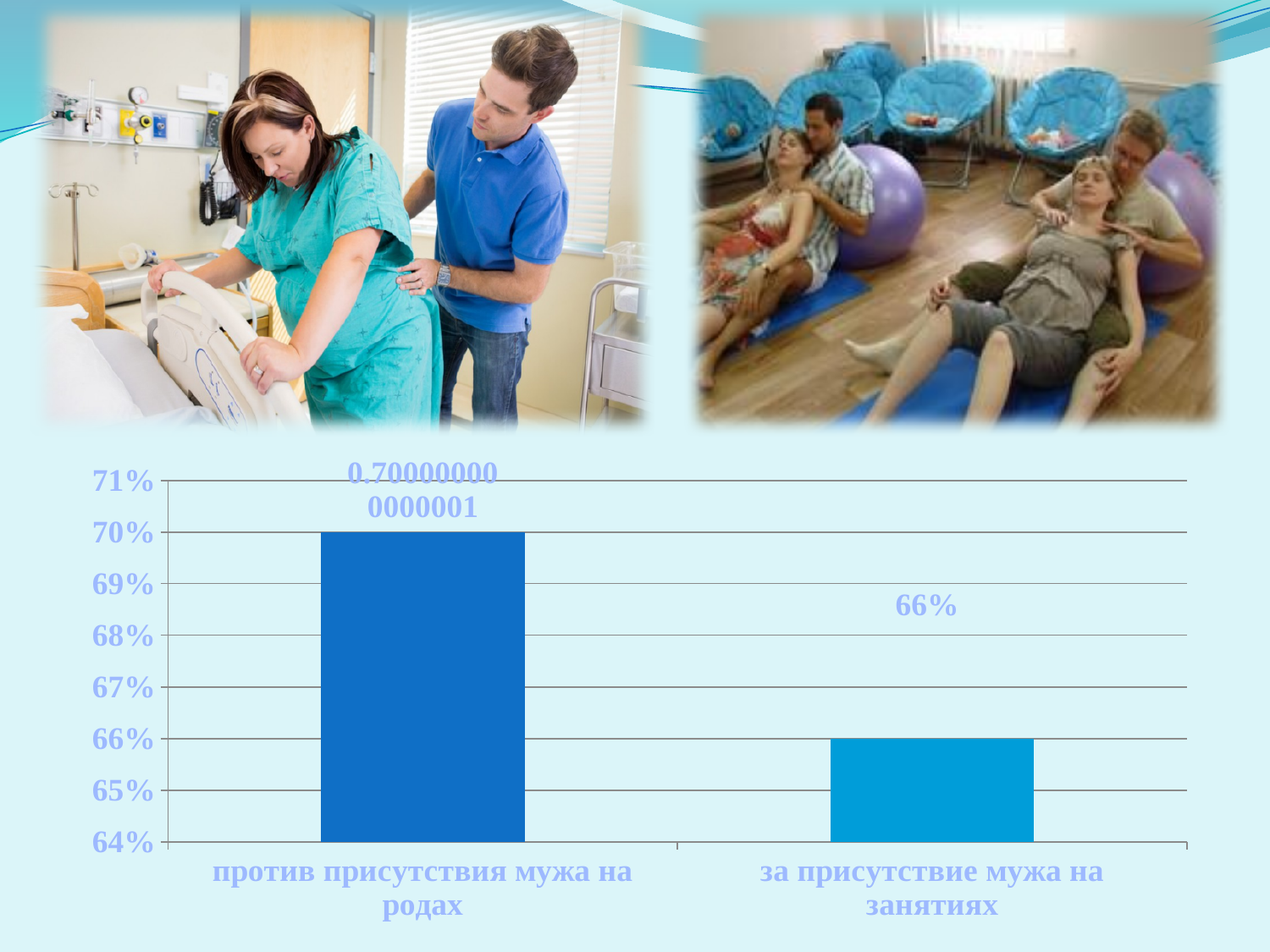
How many categories are shown in the chart? 2 What is the value for "за присутствие мужа на занятиях"? 66% Is the value for "против присутствия мужа на родах" greater or less than 68%? greater What kind of chart is shown on the slide? bar chart What is the lowest value shown on the vertical axis? 64% What is the highest value shown on the vertical axis? 71% Which category has the lowest value? за присутствие мужа на занятиях Which category has the highest value? против присутствия мужа на родах Is the value for "за присутствие мужа на занятиях" greater or less than 68%? less Which is larger: the value for "против присутствия мужа на родах" or the value for "за присутствие мужа на занятиях"? против присутствия мужа на родах